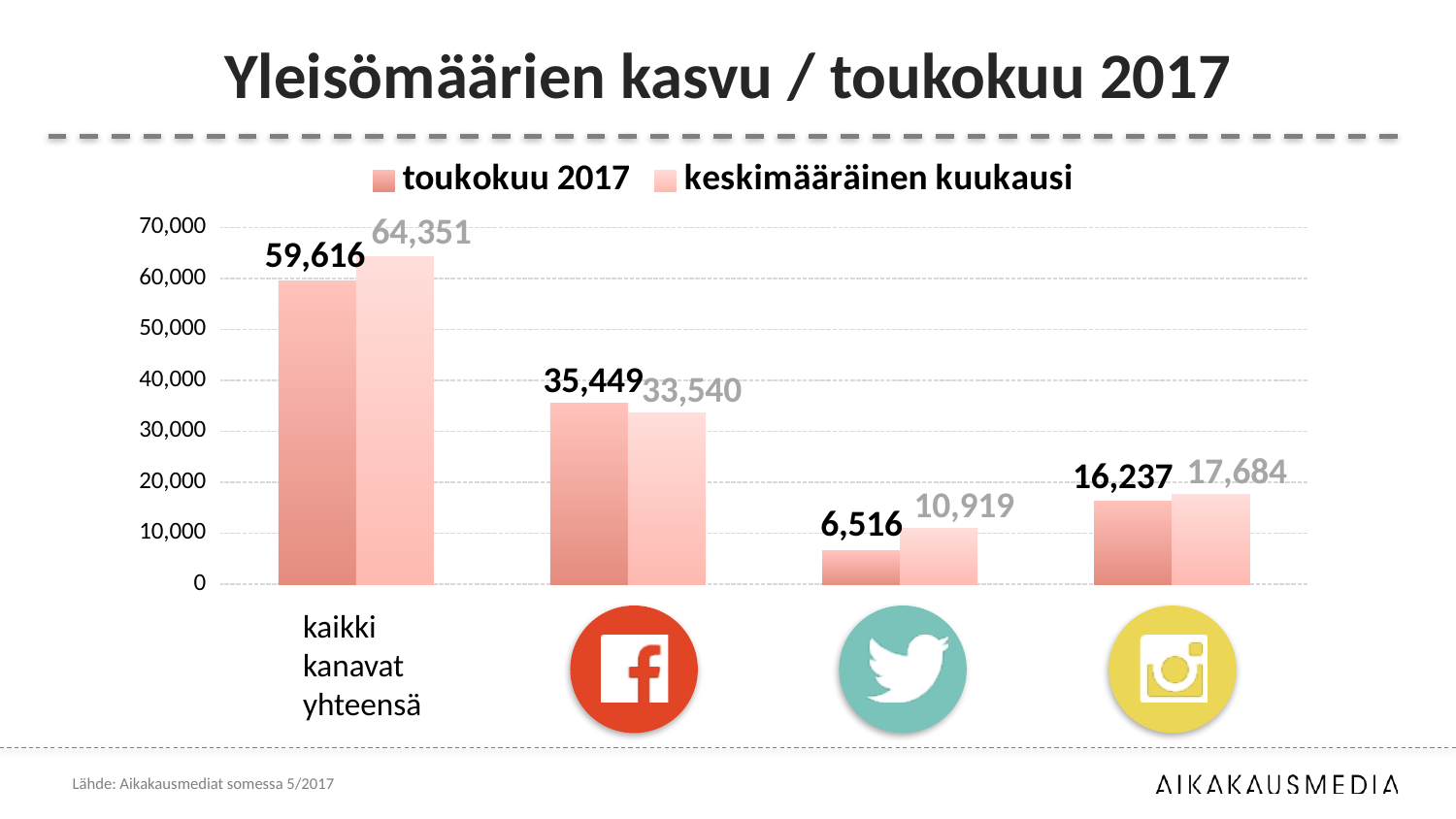
For the category marked with the Facebook icon, which is larger: the "toukokuu 2017" value or the "keskimääräinen kuukausi" value? toukokuu 2017 What is the "keskimääräinen kuukausi" value for the category marked with the Facebook icon? 33,540 For the category marked with the Twitter icon, how much larger is the "keskimääräinen kuukausi" value than the "toukokuu 2017" value? 4,403 How many series does the chart legend list? 2 What is the value for "kaikki kanavat yhteensä" in the "toukokuu 2017" series? 59,616 Which category has the lowest "toukokuu 2017" value? Twitter (the category marked with the Twitter icon) What is the "keskimääräinen kuukausi" value for the category marked with the Twitter icon? 10,919 What is the difference between the "keskimääräinen kuukausi" and "toukokuu 2017" values for "kaikki kanavat yhteensä"? 4,735 What is the "toukokuu 2017" value for the category marked with the Instagram icon? 16,237 What type of chart is shown on the slide? Bar chart How many categories are shown on the x axis of the chart? 4 Which category has the highest "keskimääräinen kuukausi" value? kaikki kanavat yhteensä